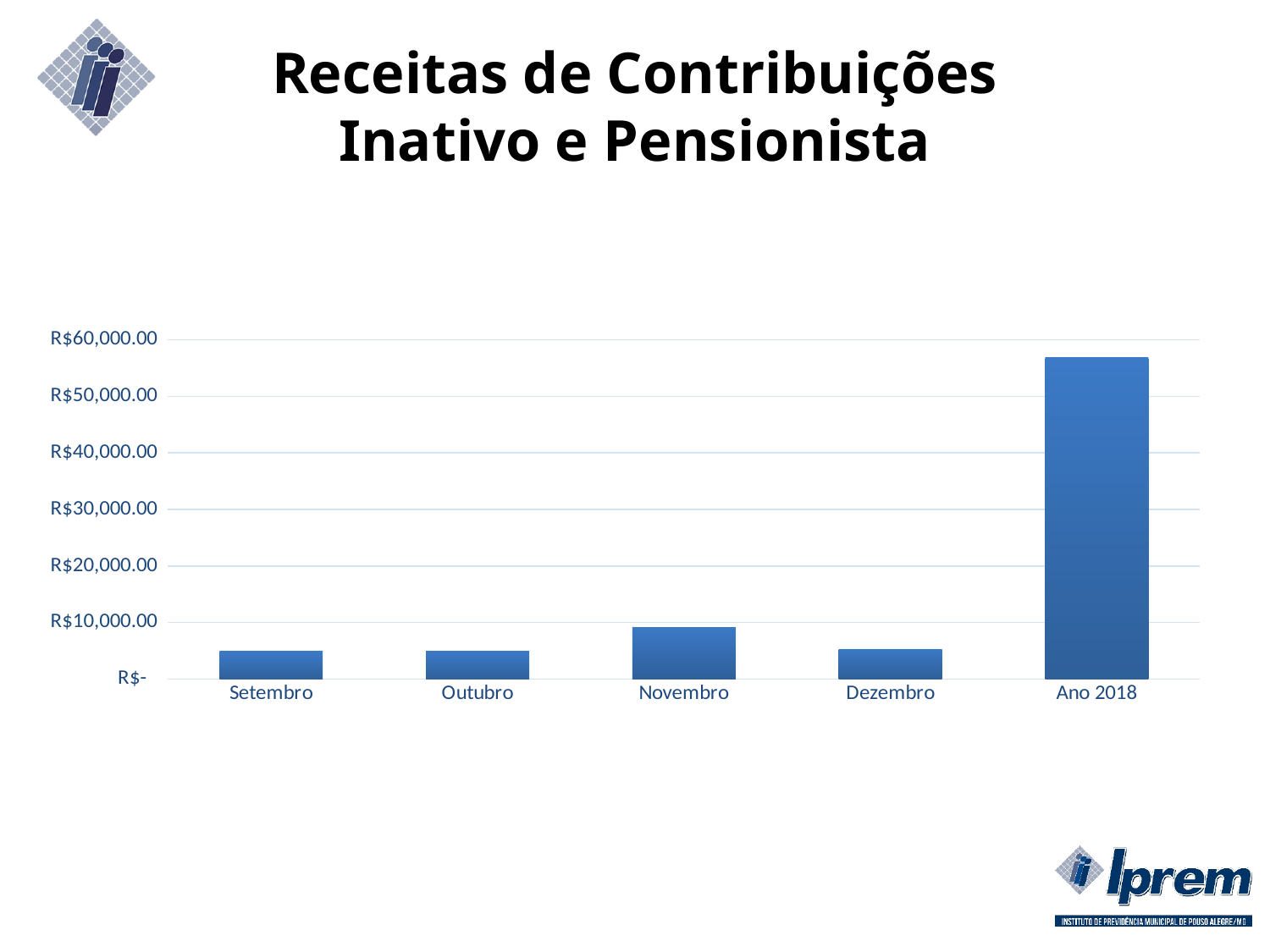
What kind of chart is shown on the slide? bar chart Which category has the highest value in the chart? Ano 2018 How many categories are shown on the x axis of the chart? 5 Which is larger, the value for Novembro or the value for Outubro? Novembro Is the value for Ano 2018 greater or less than R$60,000.00? less What is the title shown above the chart on the slide? Receitas de Contribuições Inativo e Pensionista Is the value for Novembro greater or less than R$10,000.00? less Is the value for Setembro greater or less than R$10,000.00? less Which is larger, the value for Ano 2018 or the value for Dezembro? Ano 2018 What is the highest value labelled on the vertical axis of the chart? R$60,000.00